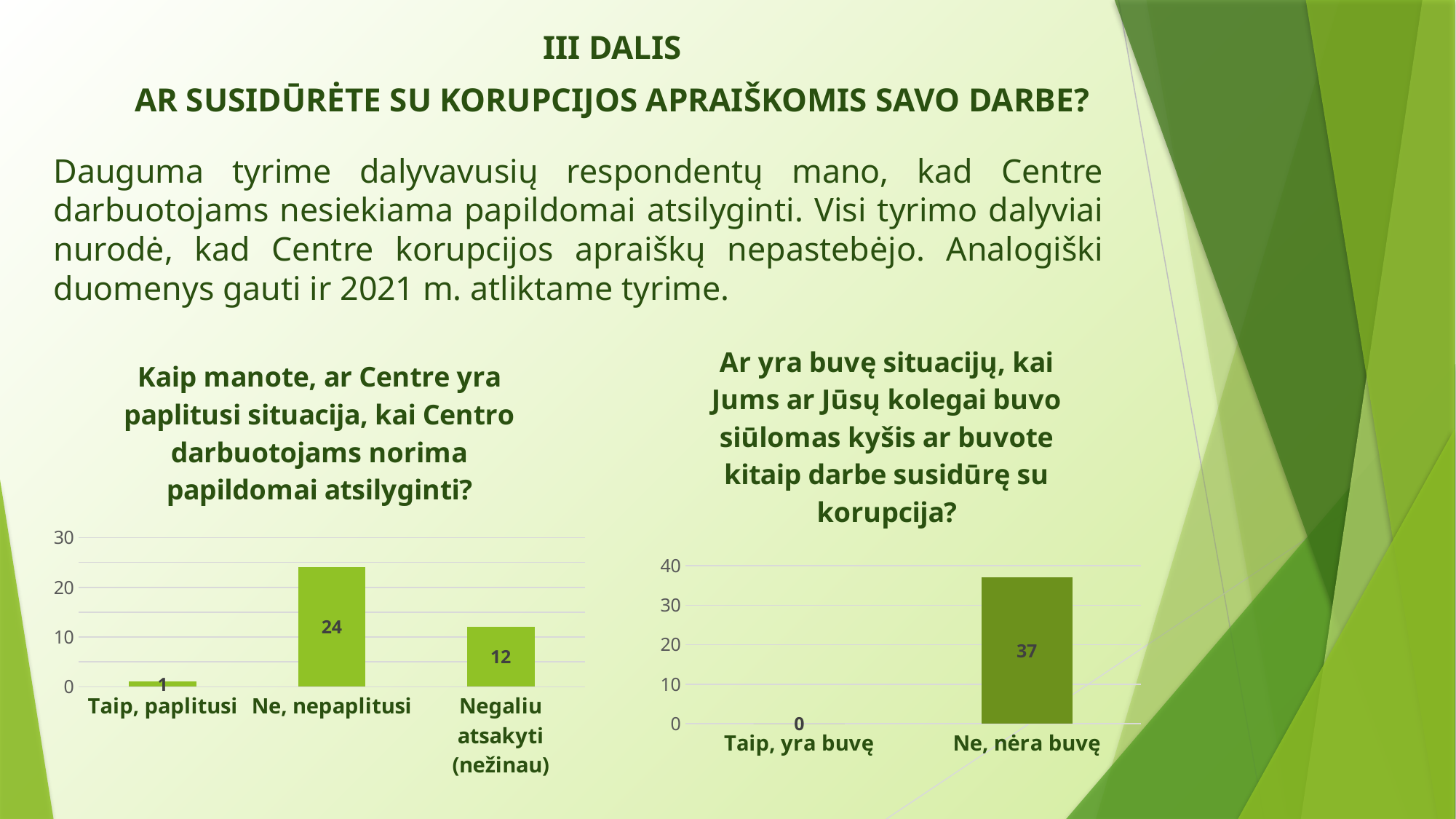
In the left chart, what is the value for "Negaliu atsakyti (nežinau)"? 12 In the left chart ("Kaip manote, ar Centre yra paplitusi situacija..."), what is the value for "Ne, nepaplitusi"? 24 In the right chart ("Ar yra buvę situacijų..."), what is the value for "Ne, nėra buvę"? 37 In the left chart, how many categories are shown? 3 In the left chart, which category has the highest value? Ne, nepaplitusi In the right chart, which of the two categories has the larger value? Ne, nėra buvę In the right chart, how many categories are shown? 2 In the left chart, what is the value for "Taip, paplitusi"? 1 In the left chart, which category has the lowest value? Taip, paplitusi In the left chart, what is the difference between the values for "Ne, nepaplitusi" and "Negaliu atsakyti (nežinau)"? 12 In the right chart, what is the value for "Taip, yra buvę"? 0 What type of chart is the right chart? Bar chart